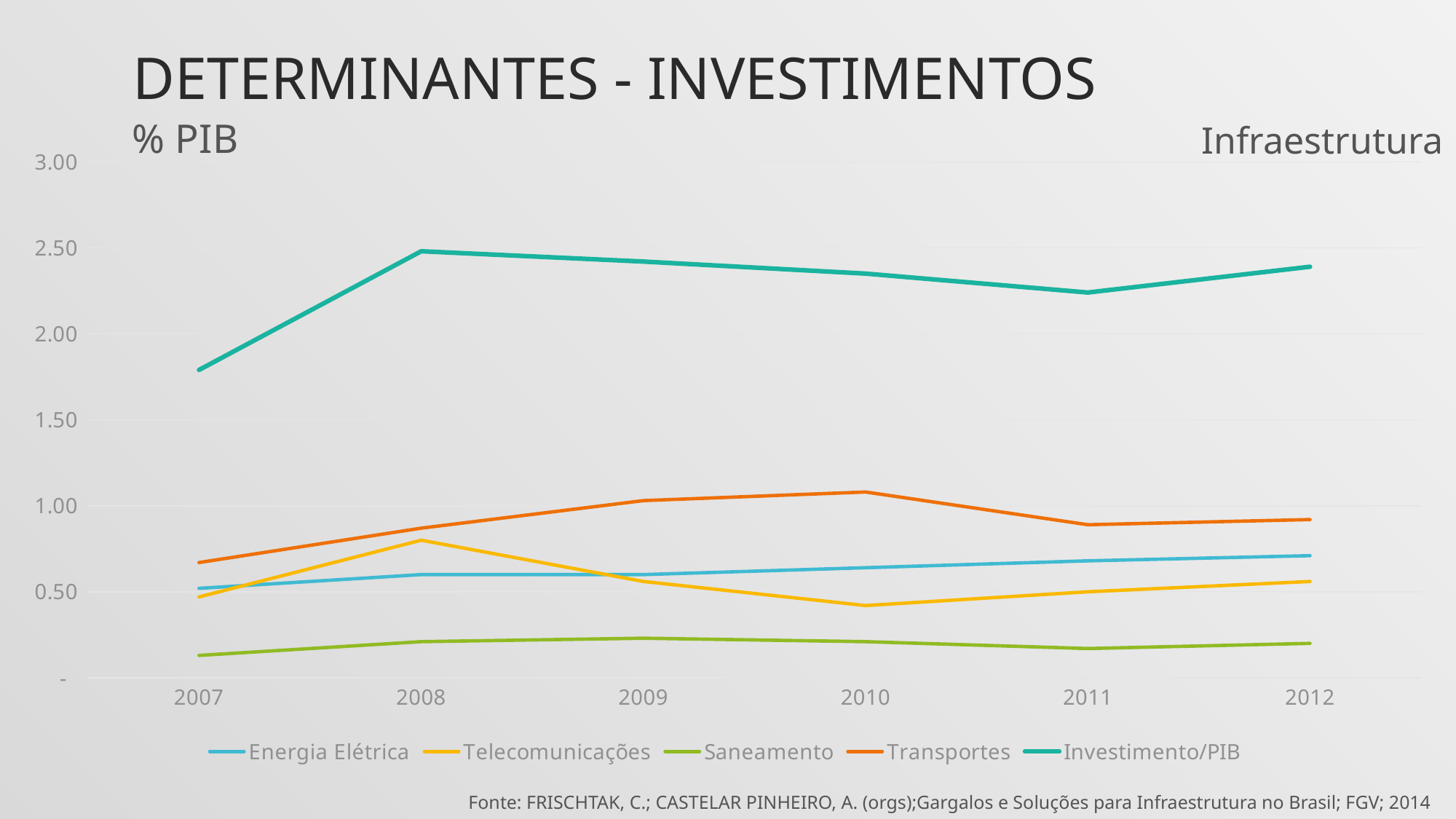
In which year is the Investimento/PIB line at its highest? 2008 In which year does the Telecomunicações line reach its peak? 2008 In which year is the Investimento/PIB line at its lowest? 2007 How many years are plotted along the x axis? 6 Which series stays lowest across all years? Saneamento Is the value for Investimento/PIB in 2007 greater or less than 2.00? less Is the value for Saneamento in 2009 greater or less than 0.50? less Is the value for Transportes in 2010 greater or less than 1.00? greater In 2012, which is higher: Energia Elétrica or Telecomunicações? Energia Elétrica How many series does the legend list? 5 What kind of chart is shown on the slide? line chart What unit label is shown above the y axis? % PIB